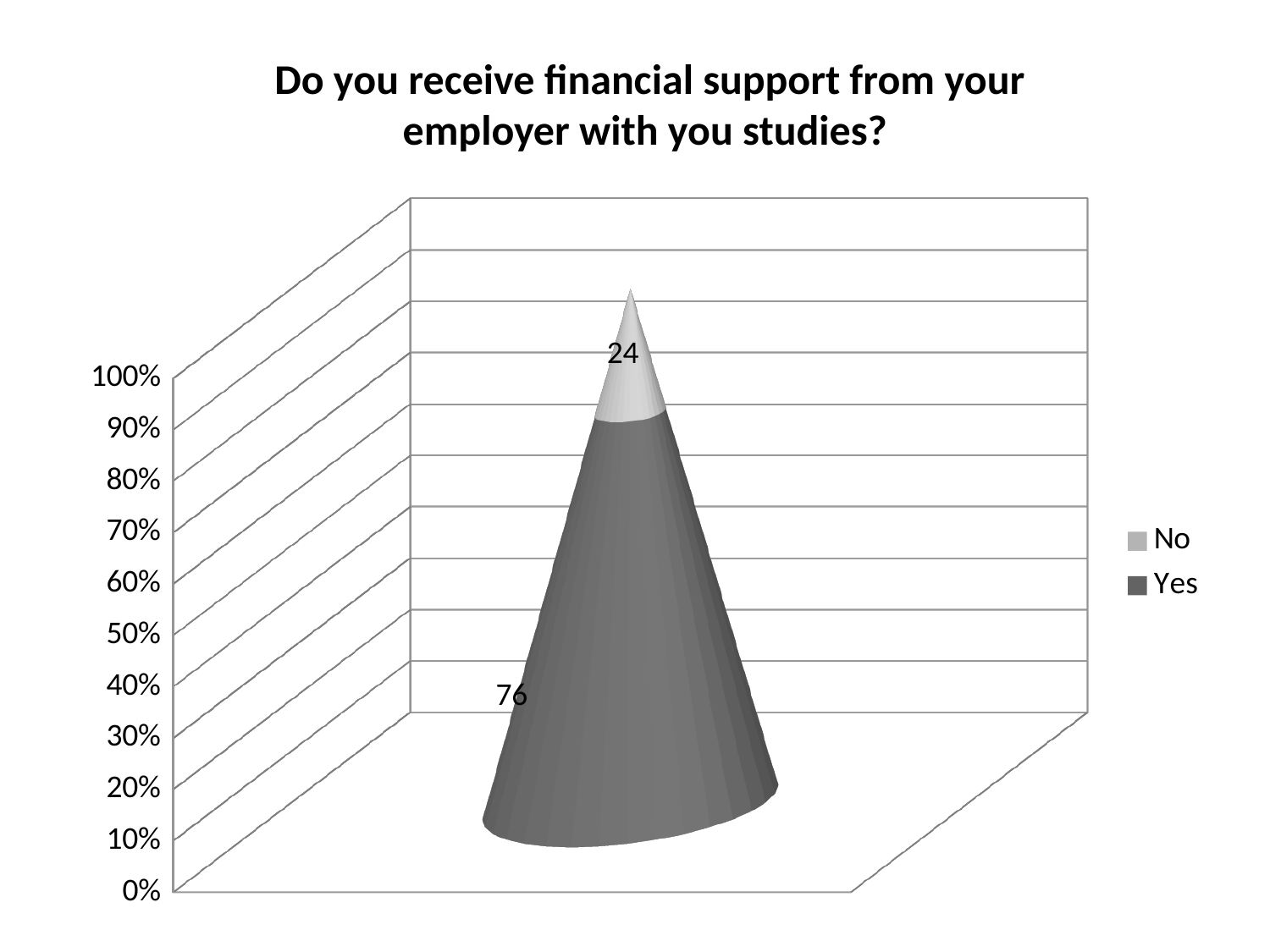
What is the title of the chart? Do you receive financial support from your employer with you studies? What is the data label for the Yes series? 76 What is the total of the two stacked segments? 100 What is the highest value shown on the vertical axis? 100% How many series does the legend list? 2 What is the data label for the No series? 24 Which series has the larger value, Yes or No? Yes Which series has the largest value? Yes Which series has the smallest value? No What are the entries in the chart legend? No, Yes What is the difference between the Yes value and the No value? 52